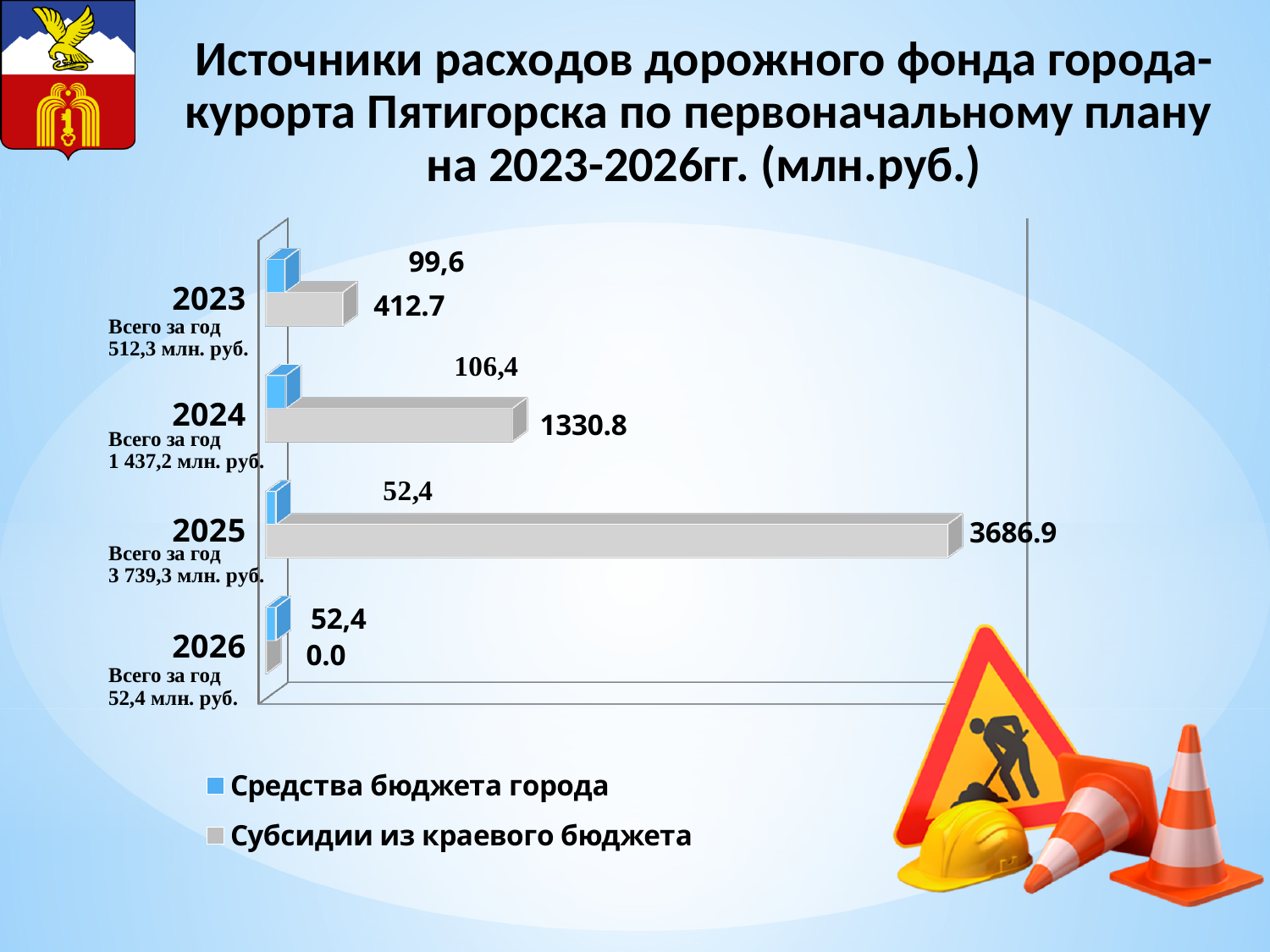
Which year has the highest value for 'Субсидии из краевого бюджета'? 2025 What total for the year is printed next to 2025? 3 739,3 млн. руб. Which year has the lowest value for 'Субсидии из краевого бюджета'? 2026 How many series does the legend list? 2 How many years (categories) are shown in the chart? 4 Which is larger for 2023: 'Средства бюджета города' or 'Субсидии из краевого бюджета'? Субсидии из краевого бюджета What type of chart is shown on the slide? bar chart What is the value of 'Субсидии из краевого бюджета' for 2024? 1330.8 Which year has the highest value for 'Средства бюджета города'? 2024 What is the difference between 'Субсидии из краевого бюджета' for 2025 and 2024? 2356.1 What is the value of 'Средства бюджета города' for 2023? 99,6 What is the value of 'Субсидии из краевого бюджета' for 2026? 0.0